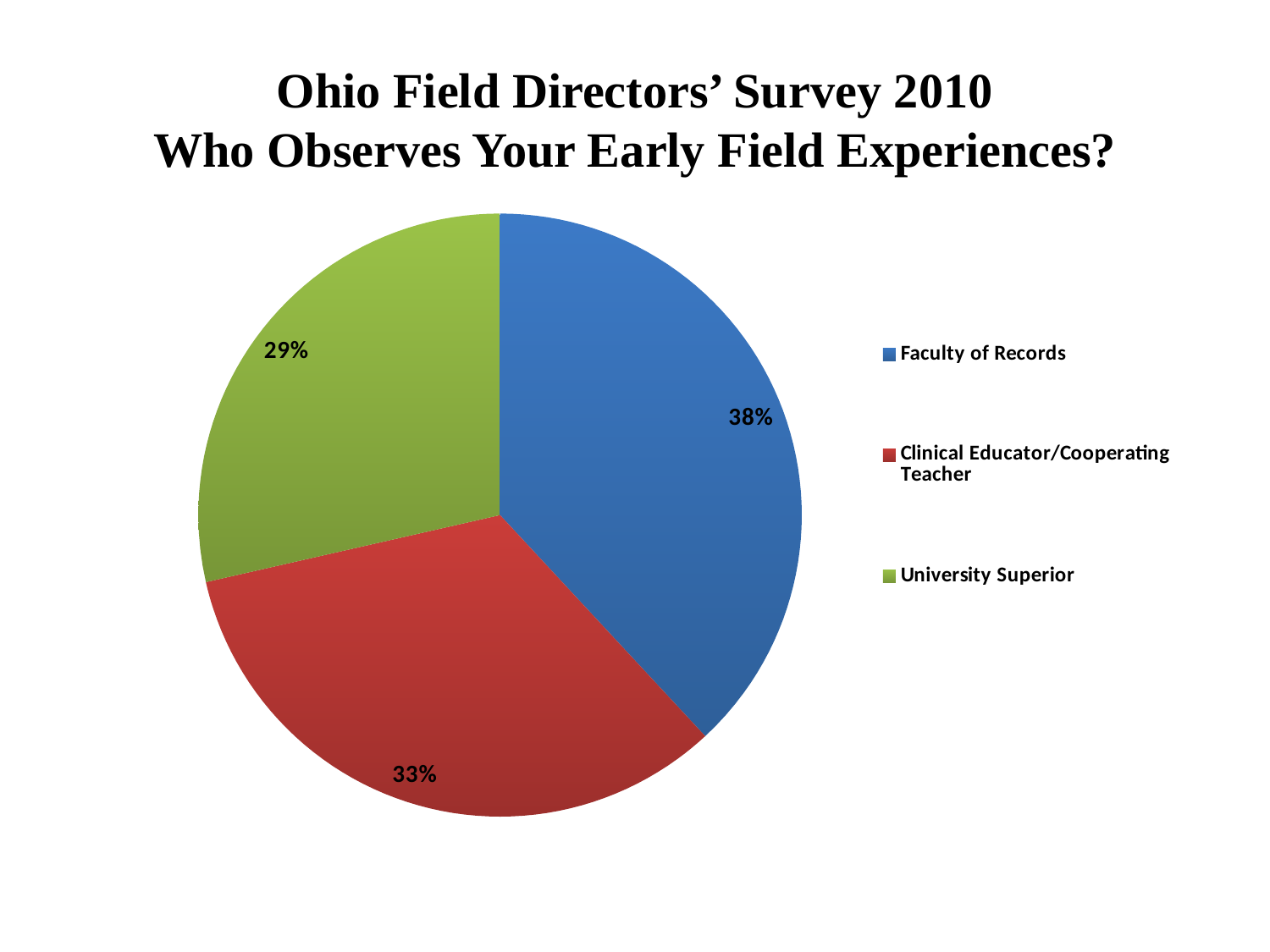
How many categories does the pie chart show? 3 What is the title of the chart on the slide? Ohio Field Directors' Survey 2010 Who Observes Your Early Field Experiences? What share of the pie does Faculty of Records have? 38% What kind of chart is shown on the slide? pie chart What share of the pie does Clinical Educator/Cooperating Teacher have? 33% Which category has the largest slice of the pie? Faculty of Records What colour is the slice for University Superior? green Which is larger, the slice for Clinical Educator/Cooperating Teacher or the slice for University Superior? Clinical Educator/Cooperating Teacher What share of the pie does University Superior have? 29% Which category has the smallest slice of the pie? University Superior What is the difference in percentage points between Faculty of Records and Clinical Educator/Cooperating Teacher? 5 What is the difference in percentage points between Faculty of Records and University Superior? 9